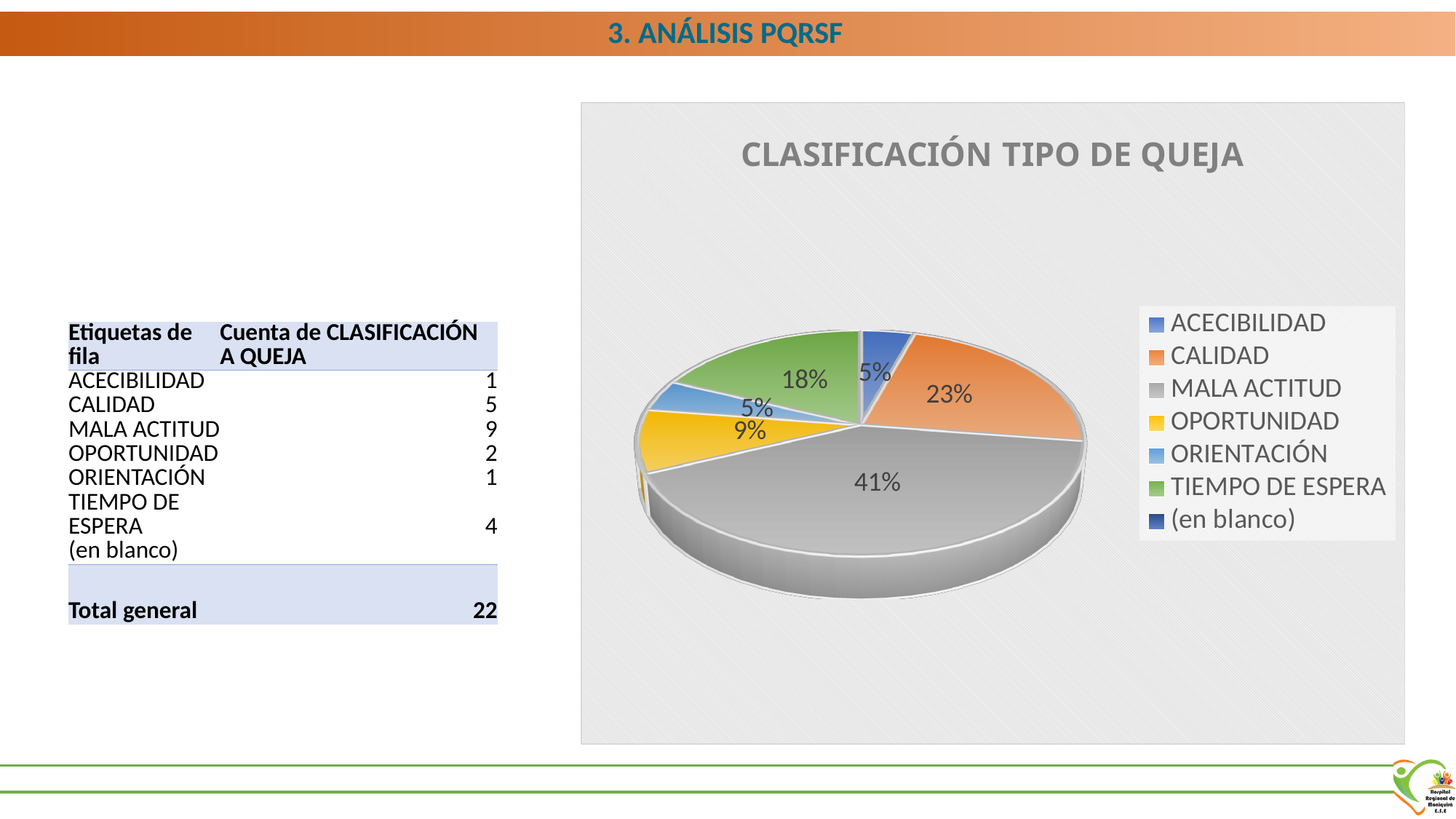
How many percentage points larger is the MALA ACTITUD slice than the CALIDAD slice? 18 What percentage is shown for CALIDAD in the pie chart? 23% What type of chart is shown on the slide? Pie chart How many entries does the chart legend list? 7 What percentage of the pie does MALA ACTITUD represent? 41% What percentage is shown for TIEMPO DE ESPERA? 18% What is the title of the chart? CLASIFICACIÓN TIPO DE QUEJA Which slice is larger, CALIDAD or TIEMPO DE ESPERA? CALIDAD What percentage is shown for OPORTUNIDAD? 9% Which category has the largest slice of the pie? MALA ACTITUD What percentage is shown for ACECIBILIDAD? 5% What colour is the MALA ACTITUD slice in the pie chart? Grey